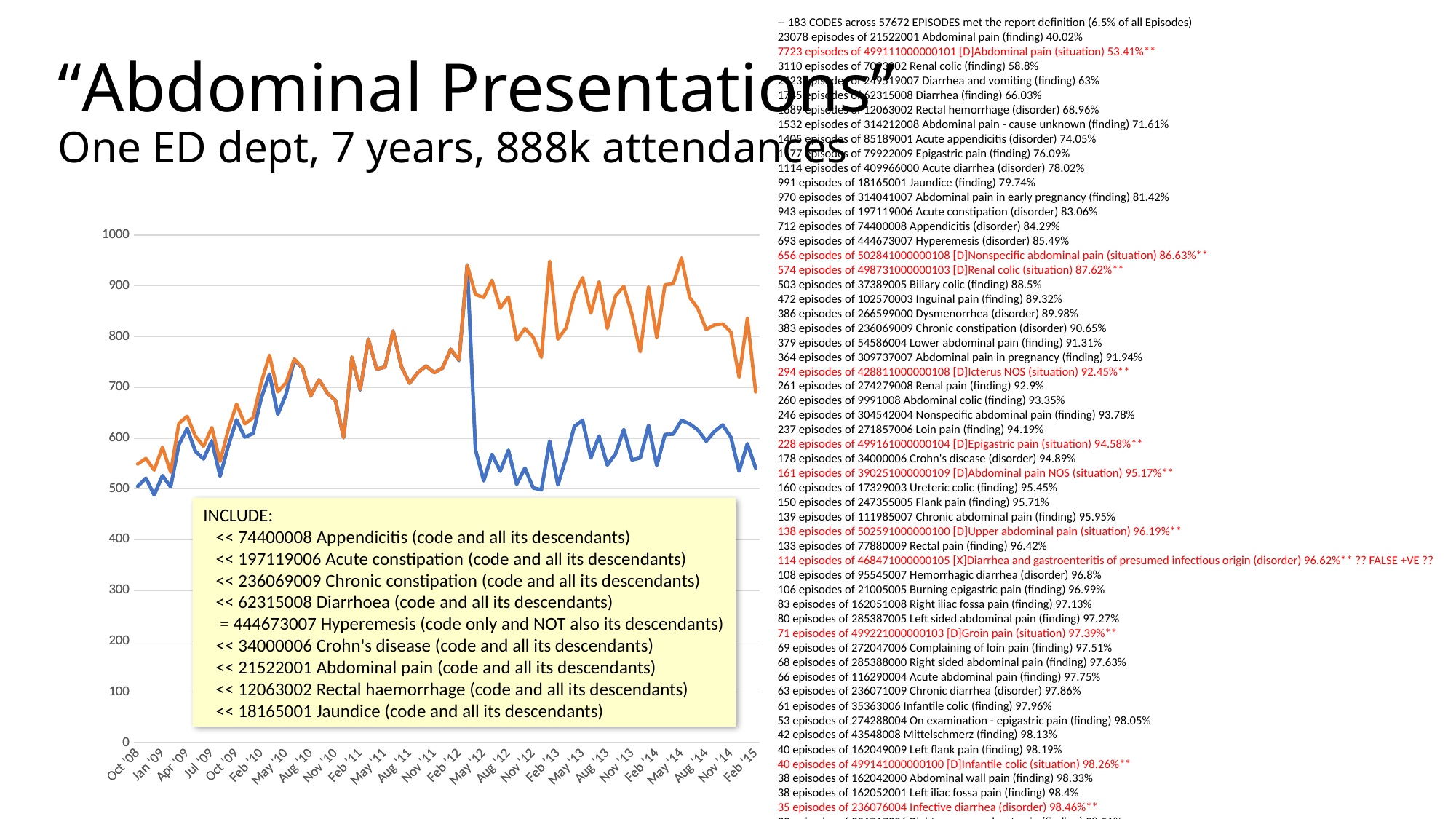
Is the value of the blue line at Oct '08 greater or less than 600? less What is the first label on the x axis of the chart? Oct '08 How many lines are plotted on the chart? 2 Is the lowest value of the blue line after May '12 greater or less than 600? less From May '12 onwards, which line is higher, the blue line or the orange line? orange Is the value of the orange line at Feb '15 greater or less than 800? less Does the blue line rise or fall sharply between Feb '12 and May '12? fall What is the highest value shown on the y axis of the chart? 1000 What kind of chart is shown on the slide? line chart Between Oct '08 and Feb '10, do the two lines generally rise or fall? rise